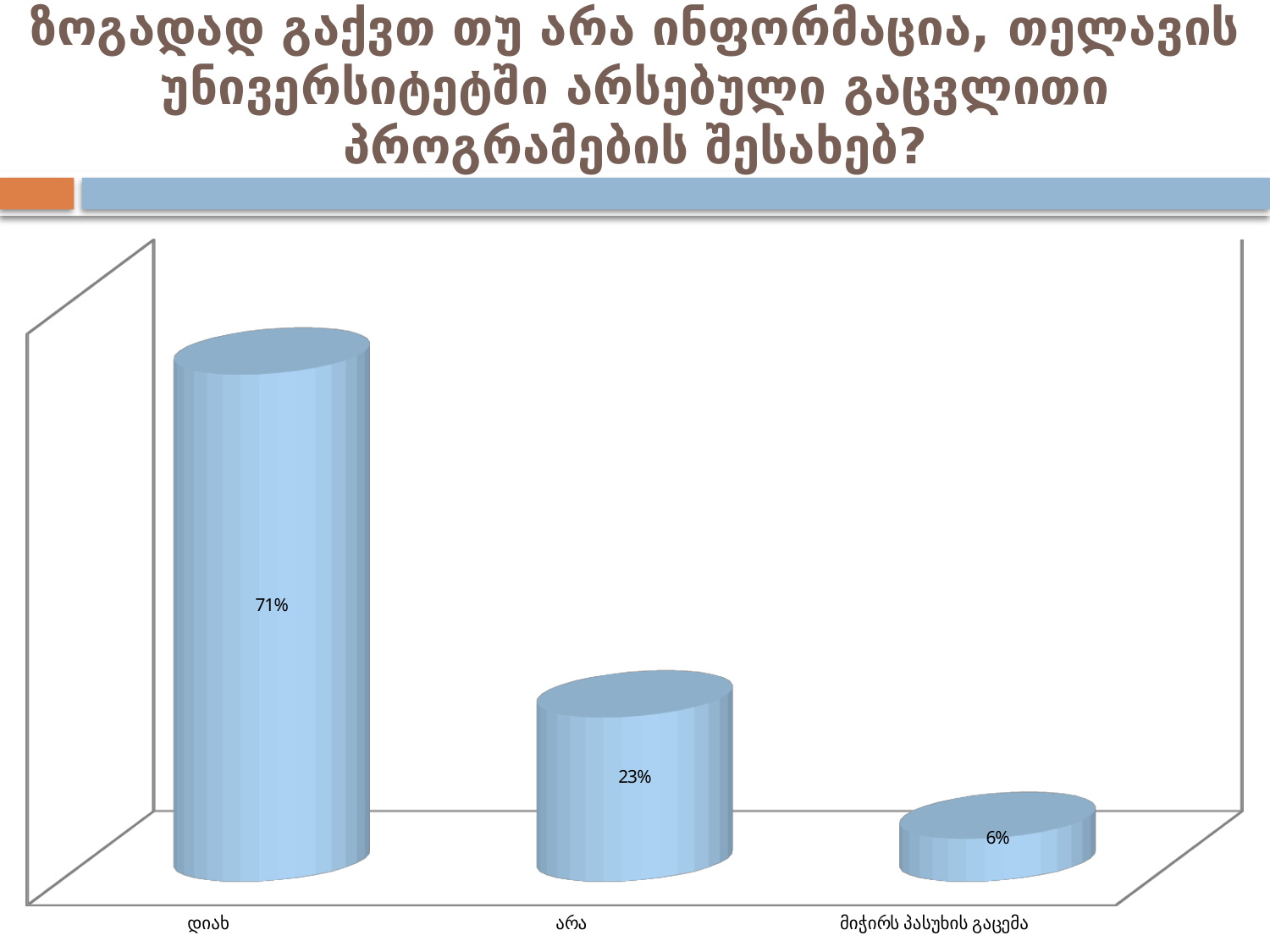
What is the difference between the values for დიახ and არა? 48% Do the values rise or fall from left to right along the x axis? fall What kind of chart is shown on the slide? bar chart What is the value for მიჭირს პასუხის გაცემა? 6% What is the title of the slide? ზოგადად გაქვთ თუ არა ინფორმაცია, თელავის უნივერსიტეტში არსებული გაცვლითი პროგრამების შესახებ? What is the value for არა? 23% Which is larger, the value for არა or the value for მიჭირს პასუხის გაცემა? არა Which category has the highest value? დიახ Which category has the lowest value? მიჭირს პასუხის გაცემა How many categories are shown on the chart? 3 What is the value for დიახ? 71% What is the difference between the values for არა and მიჭირს პასუხის გაცემა? 17%